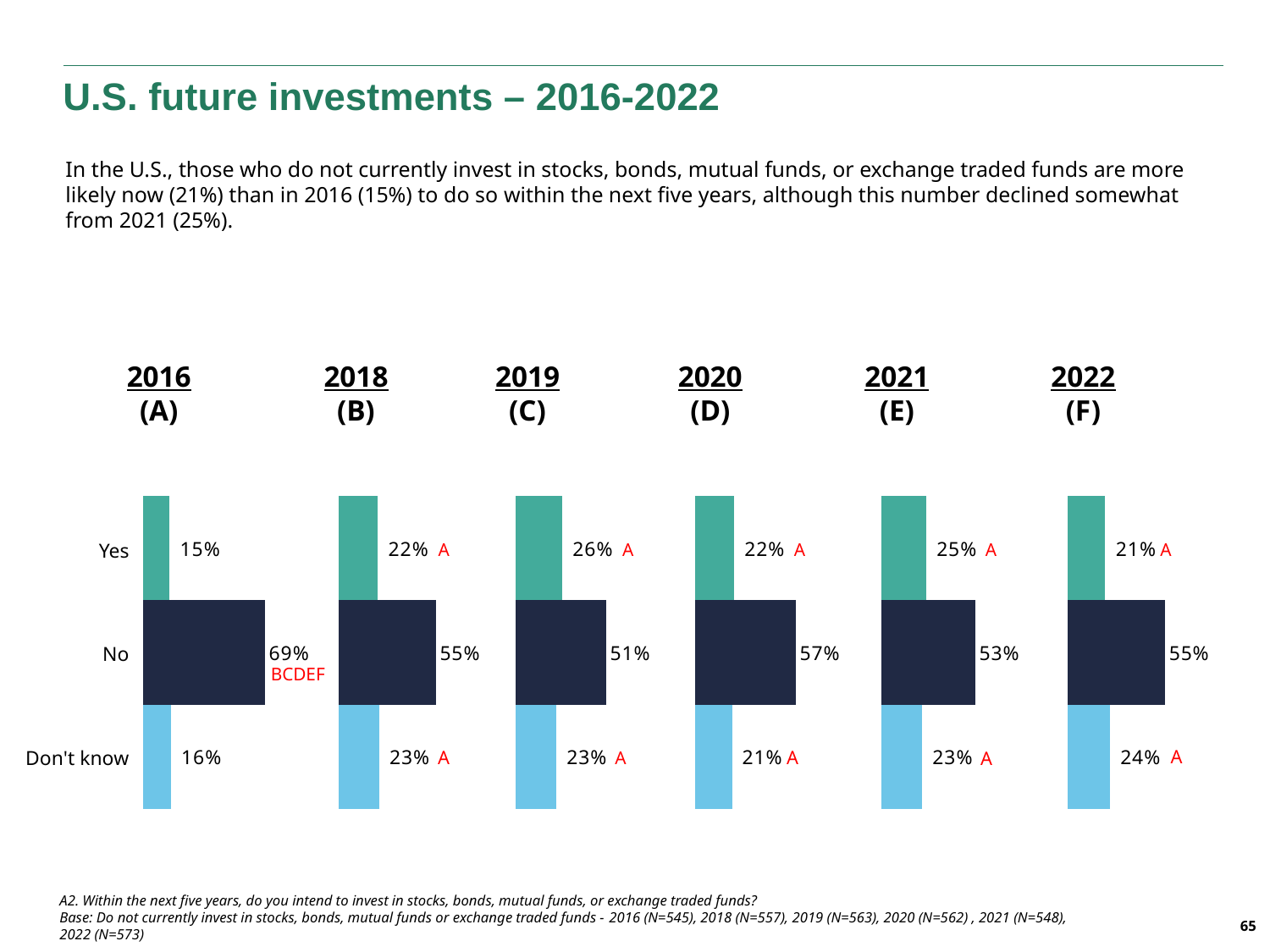
In the 2021 chart, what percentage answered "Yes"? 25% Which is larger: the "Yes" percentage in 2020 or the "Yes" percentage in 2021? 2021 What kind of chart is used to show the 2018 results? Bar chart In the 2016 chart, what percentage answered "No"? 69% Across the six yearly charts, which year has the lowest "No" percentage? 2019 What is the difference between the "No" percentage in 2016 and the "No" percentage in 2019? 18% How many yearly charts are shown on the slide? 6 What is the title of the slide containing these charts? U.S. future investments – 2016-2022 In the 2022 chart, what percentage answered "Don't know"? 24% How many response categories are shown in each yearly chart? 3 Across the six yearly charts, which year has the highest "Yes" percentage? 2019 In the 2019 chart, what percentage answered "Yes"? 26%